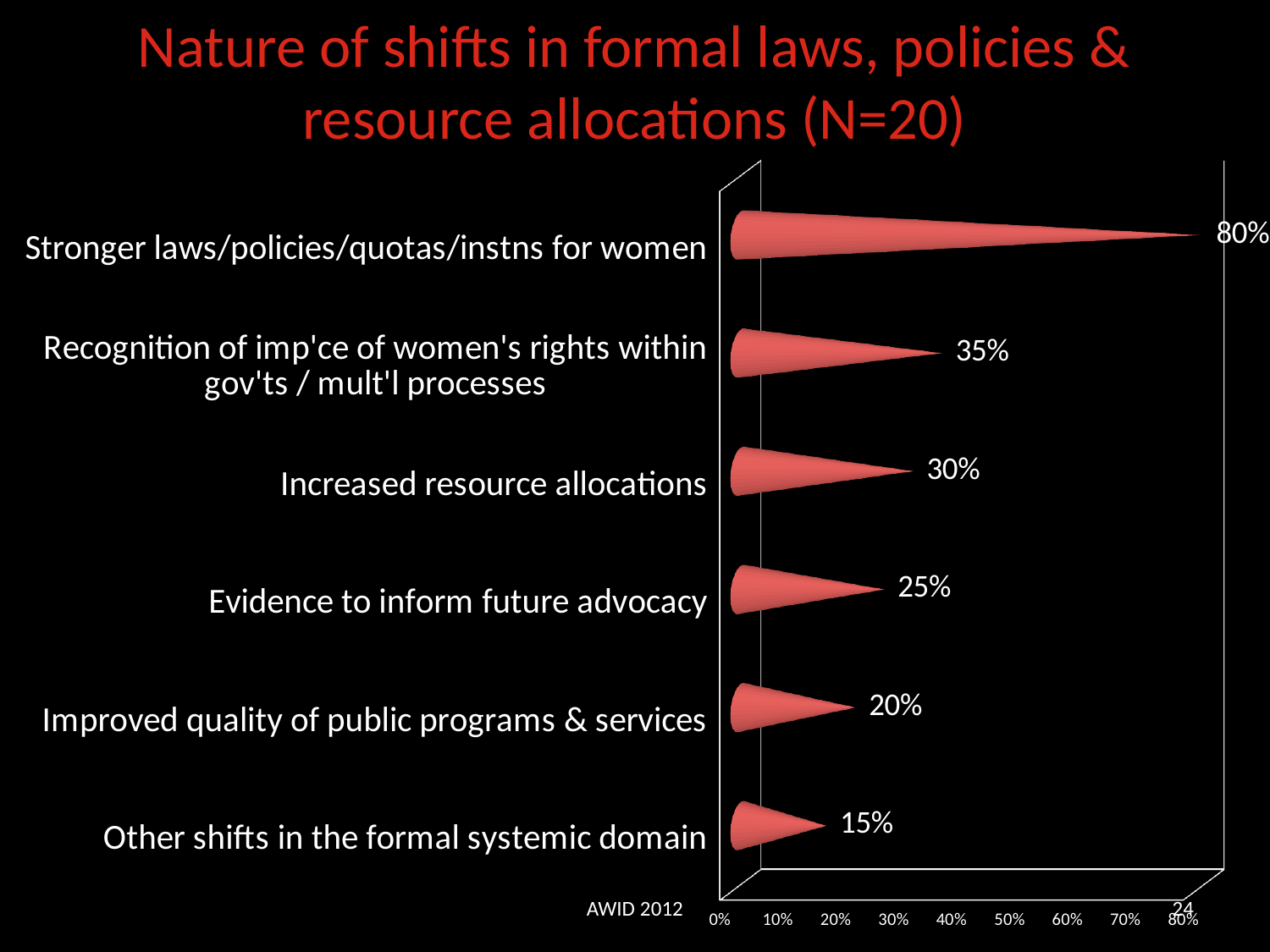
What is the title of the chart? Nature of shifts in formal laws, policies & resource allocations (N=20) What is the value for 'Improved quality of public programs & services'? 20% How many categories are shown in the chart? 6 What is the difference between the values for 'Evidence to inform future advocacy' and 'Other shifts in the formal systemic domain'? 10% Which is larger: the value for 'Increased resource allocations' or the value for 'Evidence to inform future advocacy'? Increased resource allocations What kind of chart is shown on the slide? Bar chart What is the value for 'Stronger laws/policies/quotas/instns for women'? 80% Which category has the highest value? Stronger laws/policies/quotas/instns for women Which category has the lowest value? Other shifts in the formal systemic domain What is the difference between the values for 'Stronger laws/policies/quotas/instns for women' and 'Recognition of imp'ce of women's rights within gov'ts / mult'l processes'? 45% What is the value for 'Increased resource allocations'? 30% What is the value for 'Other shifts in the formal systemic domain'? 15%